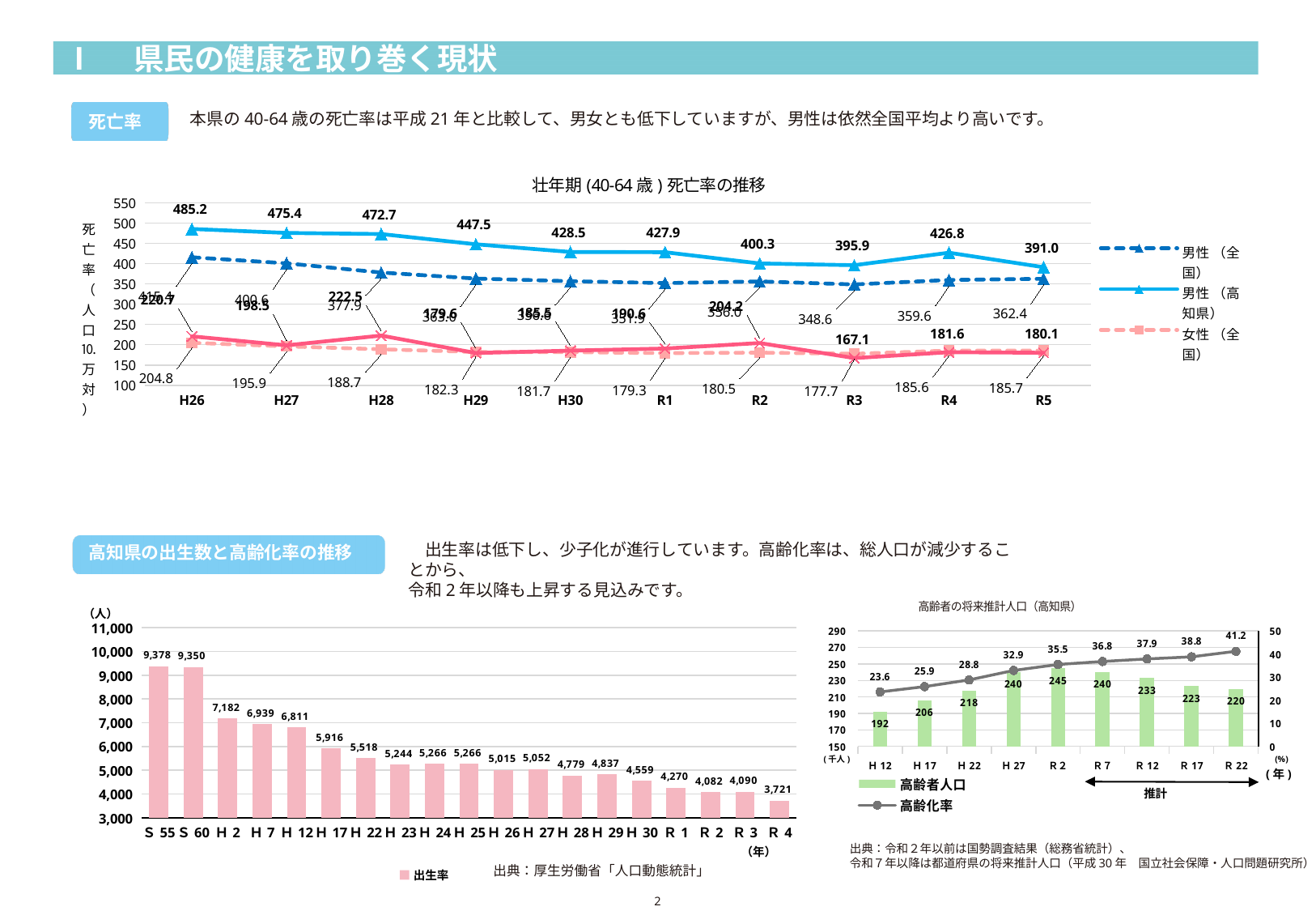
In the bottom-right chart 高齢者の将来推計人口（高知県）, how many series does the legend list? 2 In the top chart 壮年期(40-64歳)死亡率の推移, what is the difference between the 男性（高知県） values in H26 and R5? 94.2 In the top chart 壮年期(40-64歳)死亡率の推移, what is the value for 男性（高知県） in H26? 485.2 In the bottom-left bar chart of 出生数, which year has the highest value? S 55 In the bottom-left bar chart of 出生数, how many bars are plotted? 19 In the top chart 壮年期(40-64歳)死亡率の推移, what is the value for 男性（高知県） in R5? 391.0 In the bottom-right chart 高齢者の将来推計人口（高知県）, what is the 高齢化率 value for R 22? 41.2 In the top chart 壮年期(40-64歳)死亡率の推移, in which year is the 男性（高知県） value highest? H26 In the bottom-right chart 高齢者の将来推計人口（高知県）, which year has the highest 高齢者人口 value? R 2 In the top chart 壮年期(40-64歳)死亡率の推移, what is the value for 女性（全国） in R3? 177.7 In the bottom-left bar chart of 出生数, what is the value for R 4? 3,721 In the bottom-left bar chart of 出生数, what kind of chart is it? bar chart